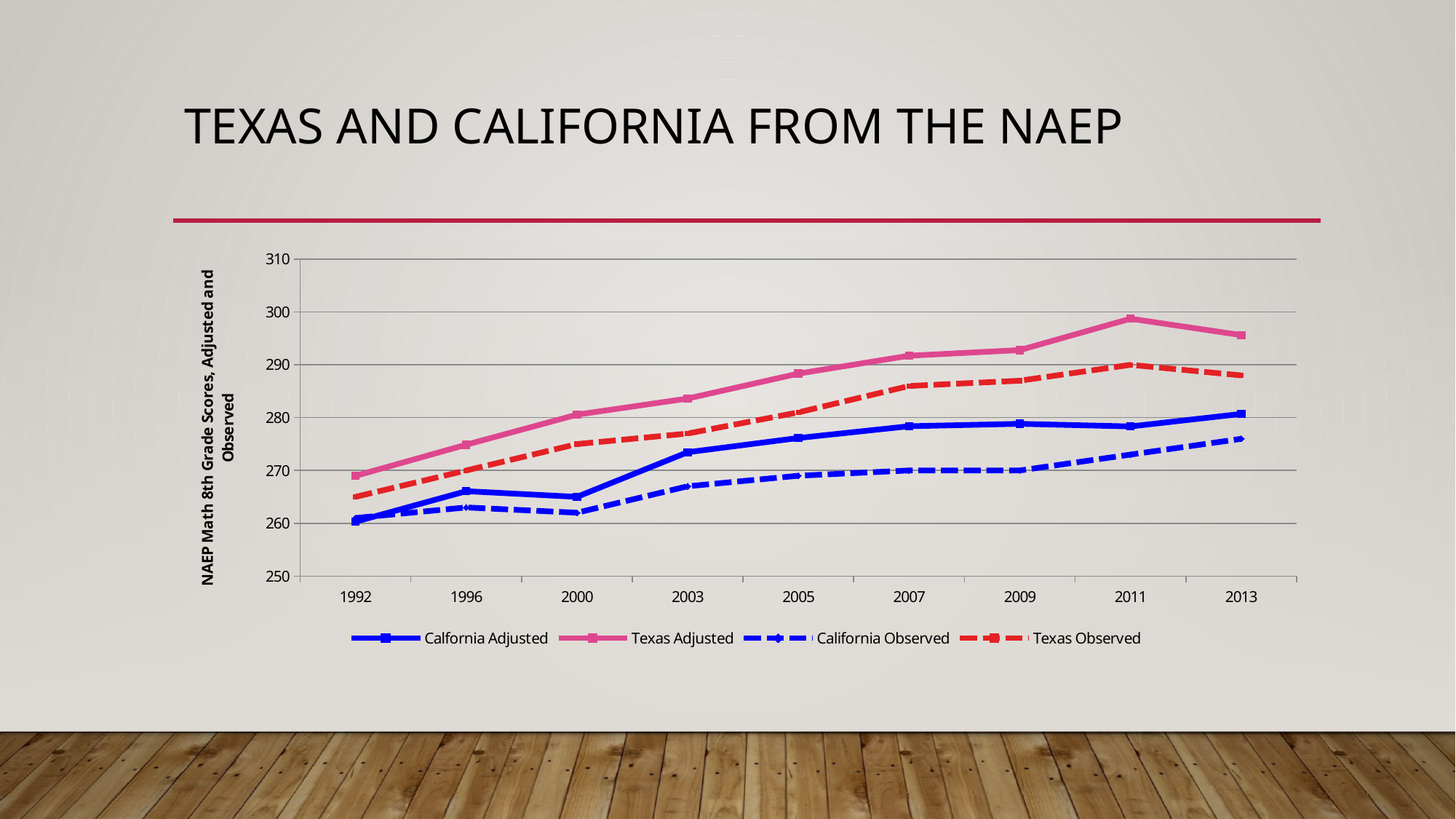
Is the value for Texas Adjusted in 2005 greater or less than 280? greater How many series does the legend list? 4 In which year is the California Adjusted series at its lowest? 1992 In 2007, which is larger: Texas Observed or California Adjusted? Texas Observed What kind of chart is shown on the slide? line chart Is the value for California Adjusted in 2000 greater or less than 270? less Does the Texas Observed series generally rise or fall from 1992 to 2011? rise Is the value for California Observed in 2003 greater or less than 270? less How many years are plotted along the x axis? 9 Which series has the highest value in 2011? Texas Adjusted In which year does the Texas Adjusted series reach its highest value? 2011